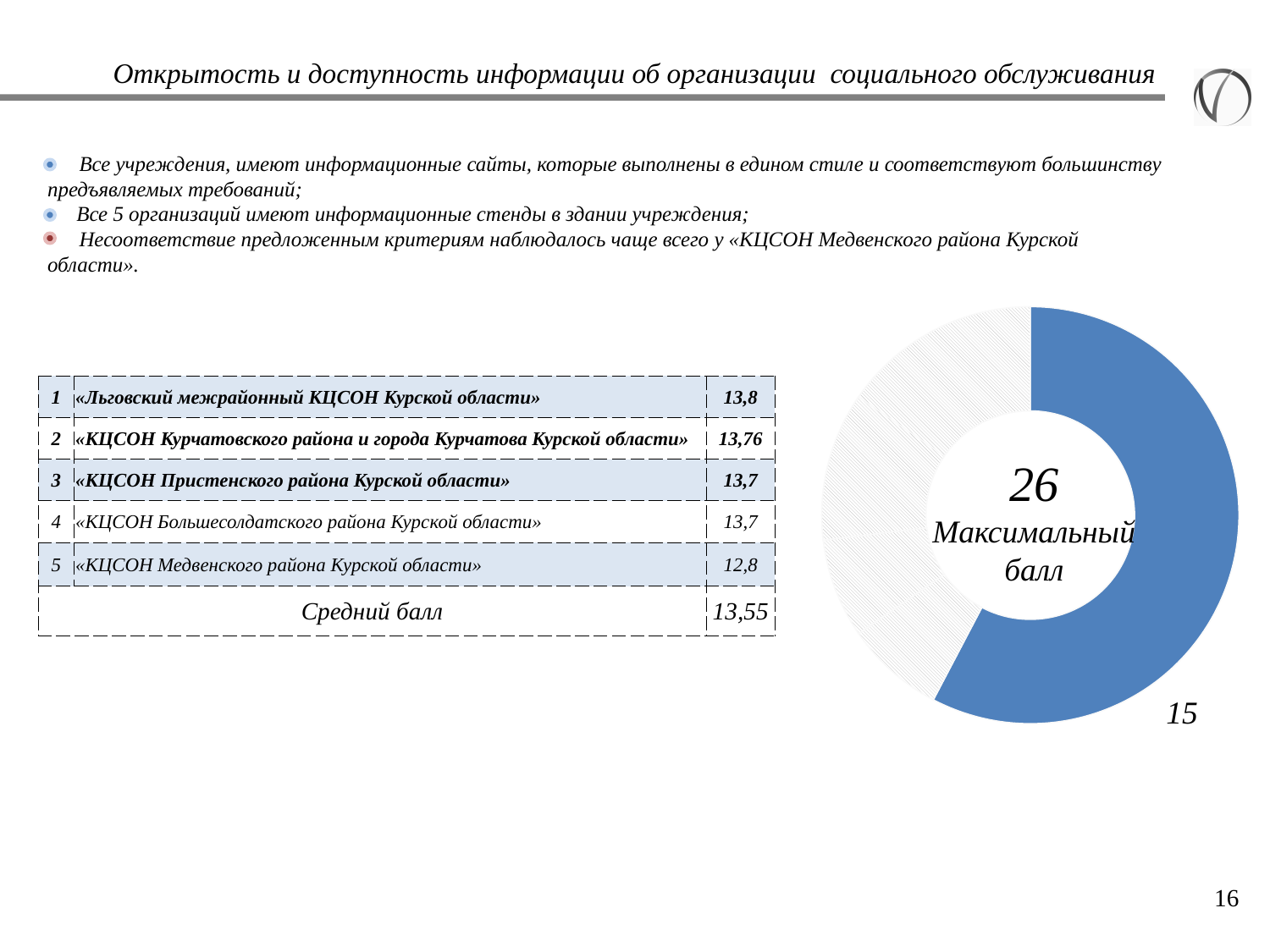
What value is printed as the data label on the blue segment of the doughnut chart? 15 What number is shown in the centre of the doughnut chart? 26 What kind of chart is shown on the right side of the slide? doughnut chart What text accompanies the number in the centre of the doughnut chart? Максимальный балл Does the blue segment of the doughnut chart cover more or less than half of the ring? more Which segment of the doughnut chart is larger, the blue one or the hatched one? the blue one